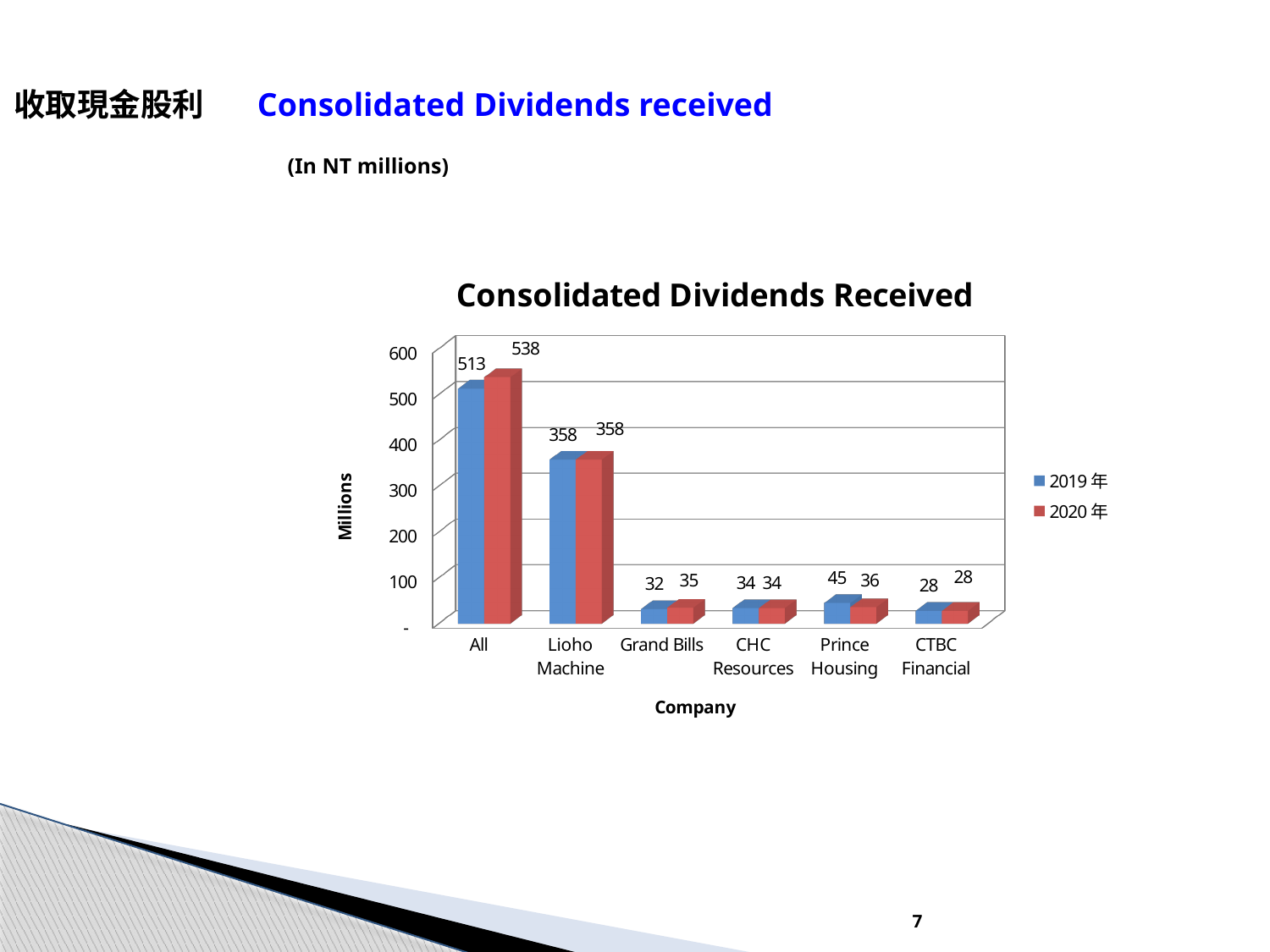
How many companies are shown on the x axis? 6 What is the difference between the 2020 年 and 2019 年 values for All? 25 What kind of chart is shown? Bar chart Which company has the lowest value in 2020 年? CTBC Financial What is the value for Grand Bills in 2020 年? 35 What is the value for All in 2019 年? 513 Which company has the highest value in 2019 年? All Which is larger for Prince Housing, the 2019 年 value or the 2020 年 value? 2019 年 How many series does the legend list? 2 What is the value for Lioho Machine in 2020 年? 358 What is the value for Prince Housing in 2019 年? 45 What is the title of the chart? Consolidated Dividends Received